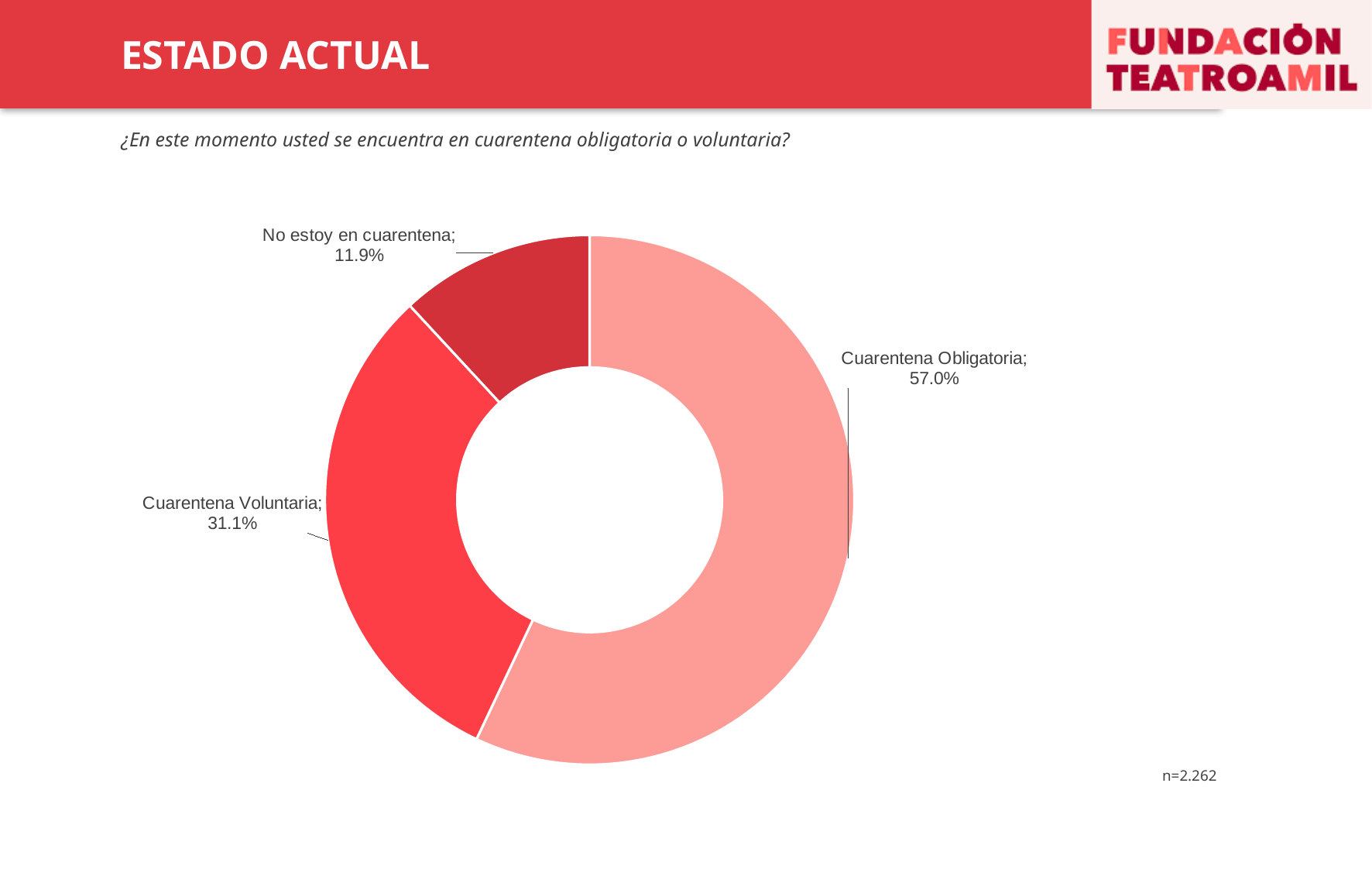
How many categories are shown in the chart? 3 What percentage of respondents are in Cuarentena Obligatoria? 57.0% Which category has the largest share of the chart? Cuarentena Obligatoria What kind of chart is shown on the slide? Pie chart (donut) What is the sample size (n) shown on the slide? n=2.262 Which is larger: Cuarentena Voluntaria or No estoy en cuarentena? Cuarentena Voluntaria What percentage of respondents are in Cuarentena Voluntaria? 31.1% What percentage of respondents answered 'No estoy en cuarentena'? 11.9% What is the difference in percentage points between Cuarentena Voluntaria and No estoy en cuarentena? 19.2 Which category has the smallest share of the chart? No estoy en cuarentena What is the difference in percentage points between Cuarentena Obligatoria and Cuarentena Voluntaria? 25.9 What survey question does the chart answer? ¿En este momento usted se encuentra en cuarentena obligatoria o voluntaria?